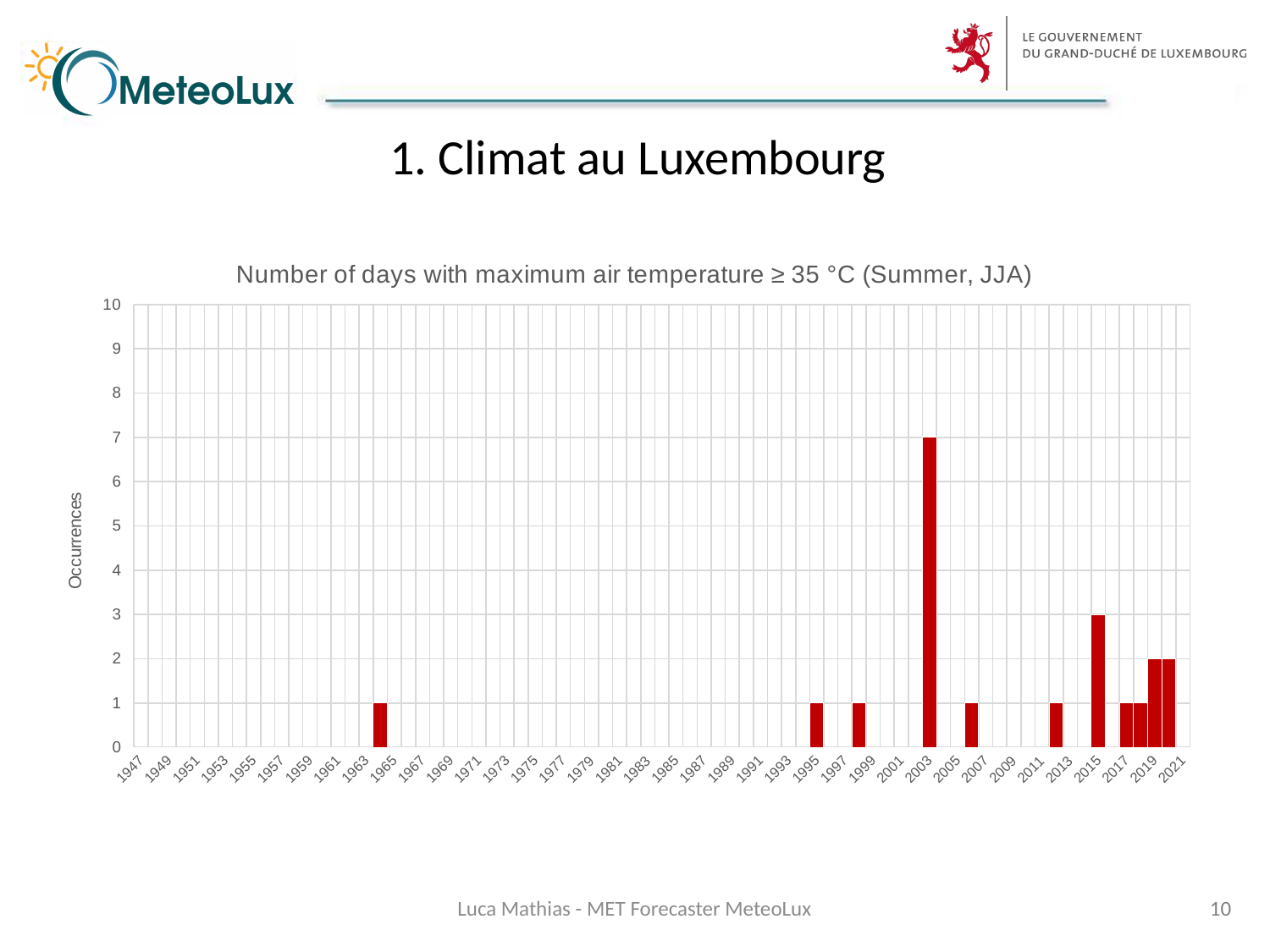
How many occurrences are shown for 2003? 7 Which year has the highest number of occurrences? 2003 Is the value for 2003 greater or less than 5? greater How many occurrences are shown for 2015? 3 What is the difference in occurrences between 2003 and 2015? 4 Which year has more occurrences, 2015 or 2019? 2015 What kind of chart is shown on the slide? bar chart How many occurrences are shown for 2019? 2 What is the label of the vertical axis? Occurrences How many occurrences are shown for 1995? 1 What is the title of the chart? Number of days with maximum air temperature ≥ 35 °C (Summer, JJA) How many occurrences are shown for 2017? 1